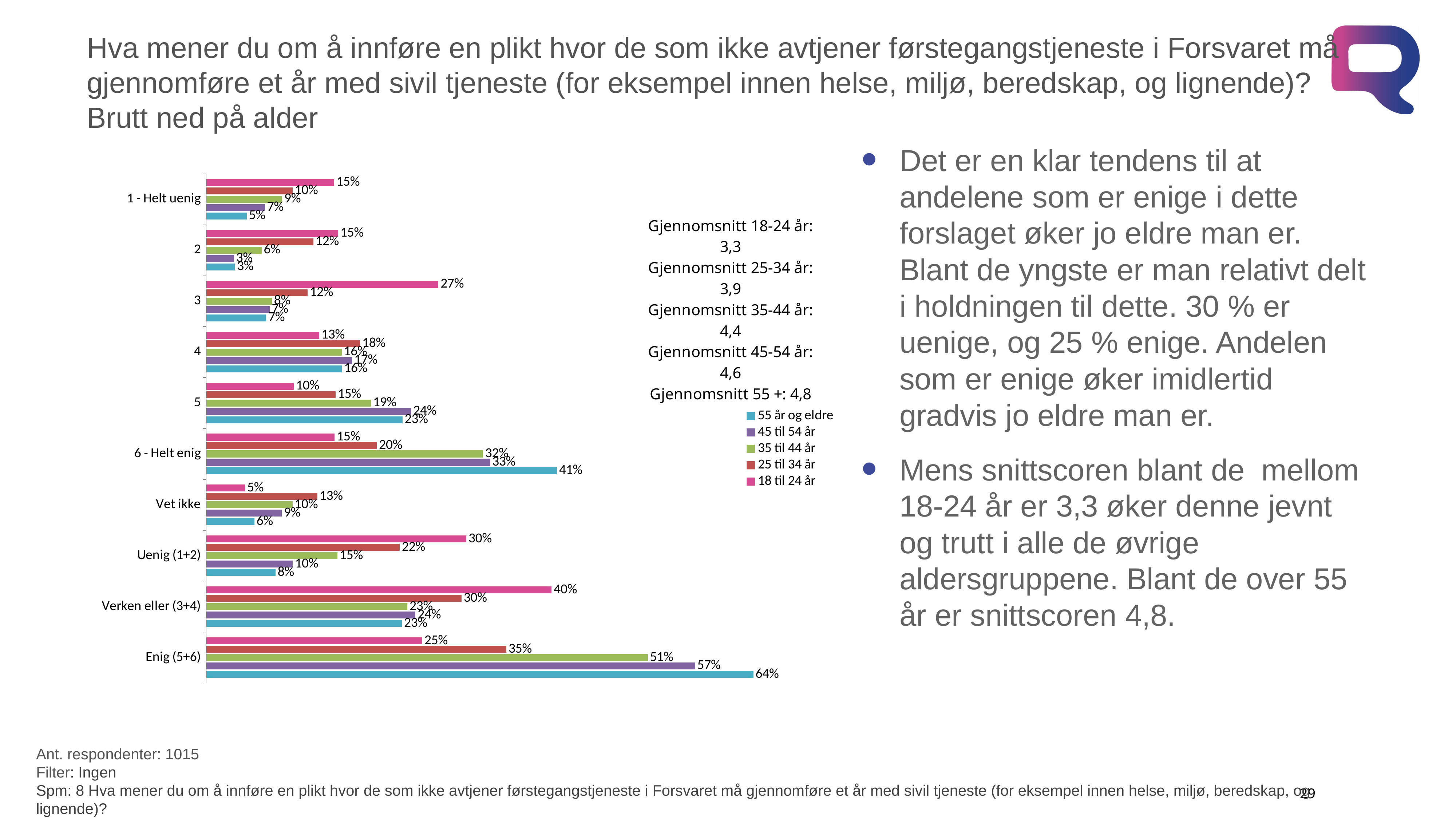
How many series does the chart legend list? 5 How many response categories are shown on the vertical axis of the chart? 10 What is the value for '55 år og eldre' in the 'Enig (5+6)' category? 64% Which colour represents the '18 til 24 år' series in the chart legend? pink What is the value for '18 til 24 år' in the 'Uenig (1+2)' category? 30% Which age group has the lowest value in the 'Verken eller (3+4)' category? 35 til 44 år and 55 år og eldre (both 23%) What is the value for '35 til 44 år' in the '6 - Helt enig' category? 32% What is the difference between the '55 år og eldre' and '18 til 24 år' values in the 'Enig (5+6)' category? 39% Which age group has the highest value in the 'Enig (5+6)' category? 55 år og eldre In the '1 - Helt uenig' category, which is larger: the value for '18 til 24 år' or for '55 år og eldre'? 18 til 24 år What is the value for '25 til 34 år' in the 'Vet ikke' category? 13% What kind of chart is shown on the slide? bar chart